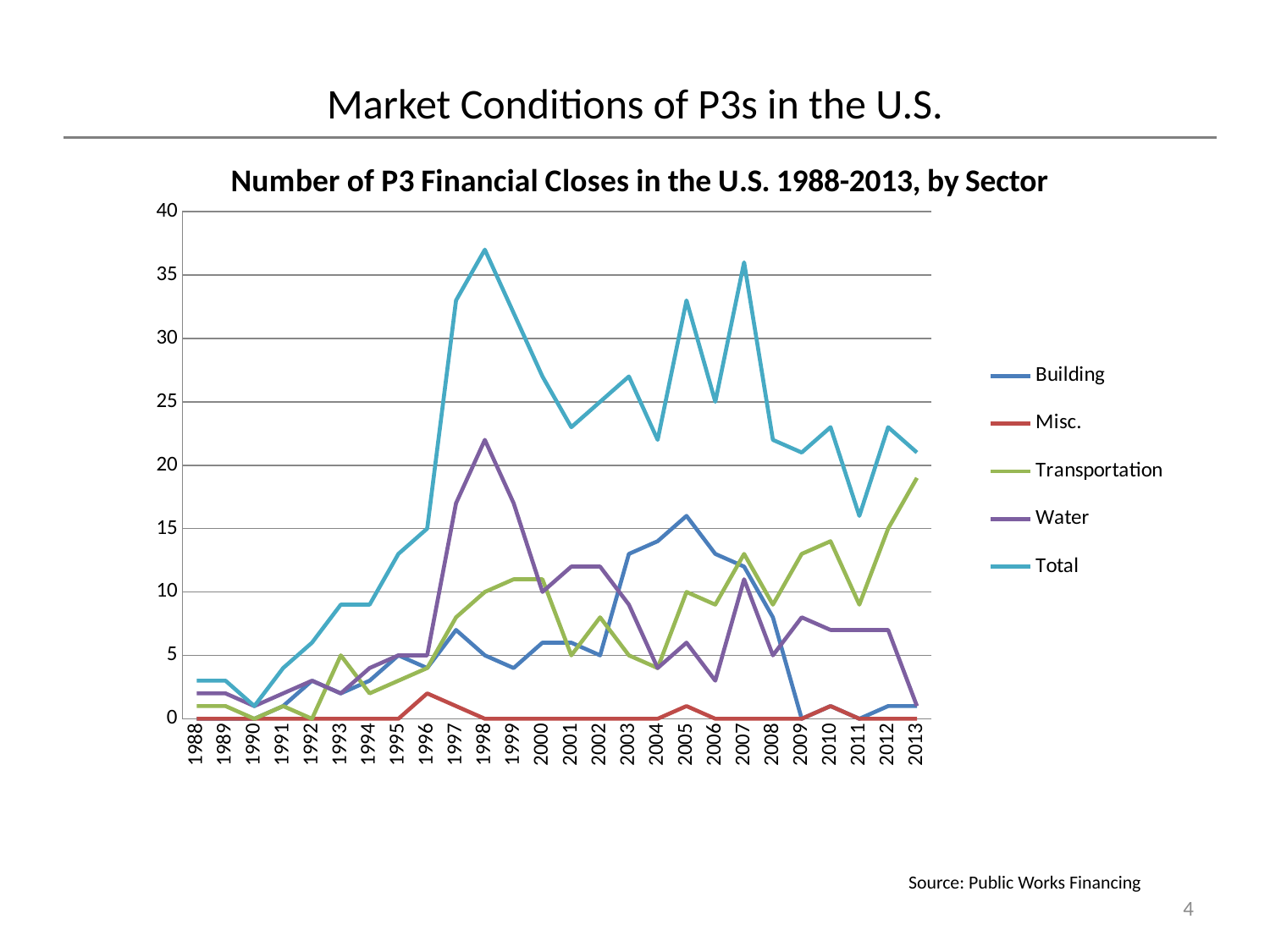
What is the value for Building in 2009? 0 In which year does the Total series reach its highest value? 1998 How many series does the legend list? 5 Is the value for Transportation in 2013 greater or less than 15? greater What is the title of the chart? Number of P3 Financial Closes in the U.S. 1988-2013, by Sector Is the value for Water in 1998 greater or less than 20? greater Does the Total series rise or fall from 1988 to 1998? rise Is the value for Total in 1998 greater or less than 35? greater In 2013, which is larger, Transportation or Water? Transportation How many years are plotted along the x axis? 26 What kind of chart is shown on the slide? line chart